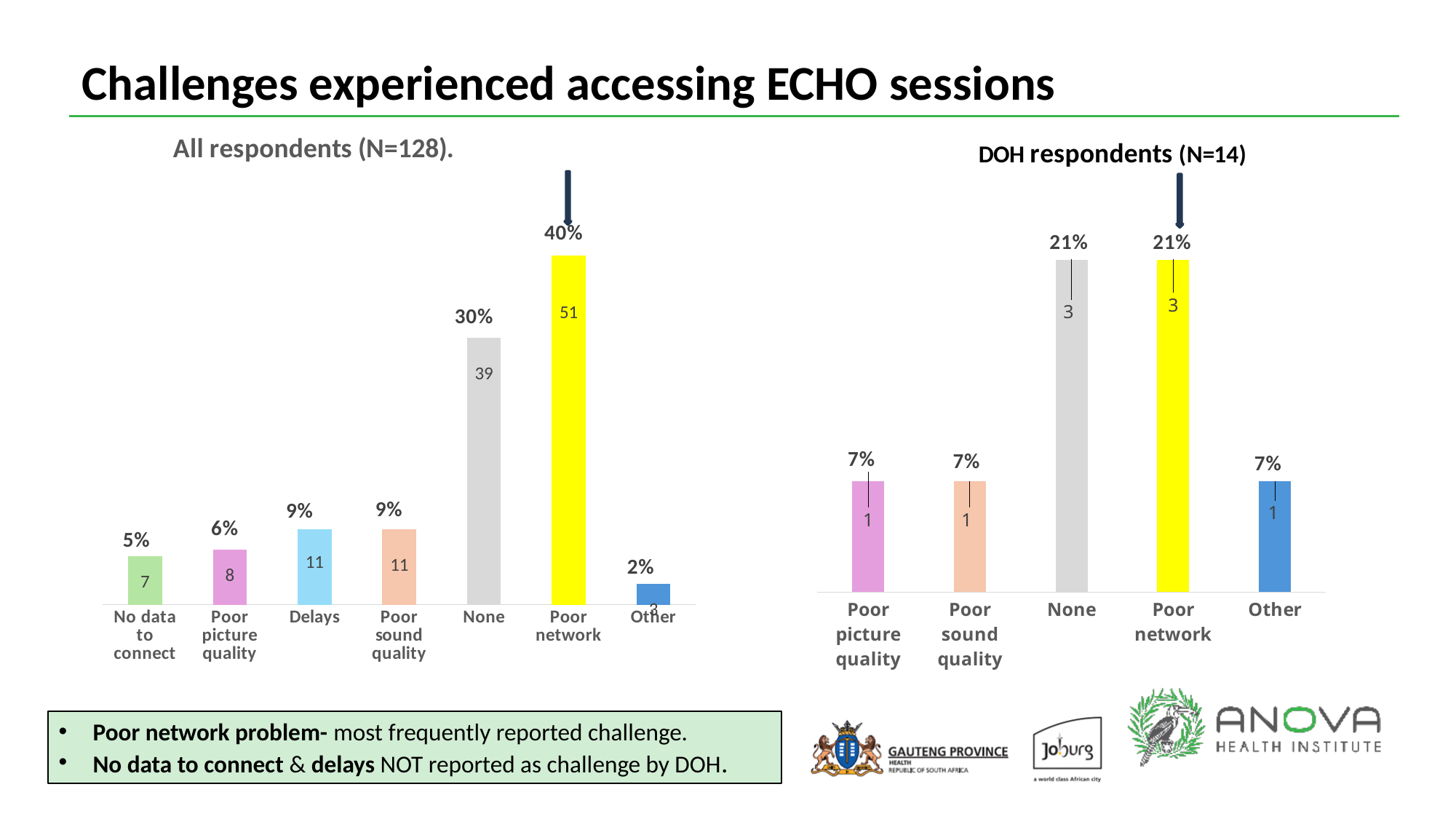
What type of chart is the 'All respondents (N=128)' chart? Bar chart In the 'All respondents (N=128)' chart, which category has the lowest percentage? Other In the 'All respondents (N=128)' chart, what is the difference in percentage points between Poor network and None? 10 In the 'All respondents (N=128)' chart, which category has the highest percentage? Poor network In the 'DOH respondents (N=14)' chart, what percentage is shown for None? 21% In the 'All respondents (N=128)' chart, what percentage is shown for No data to connect? 5% In the 'DOH respondents (N=14)' chart, what count is shown inside the Other bar? 1 How many categories are shown in the 'DOH respondents (N=14)' chart? 5 In the 'All respondents (N=128)' chart, what percentage is shown for Poor network? 40% In the 'DOH respondents (N=14)' chart, what is the difference in percentage points between Poor network and Poor sound quality? 14 In the 'All respondents (N=128)' chart, which is larger, Poor picture quality or Delays? Delays In the 'All respondents (N=128)' chart, what count is shown inside the None bar? 39